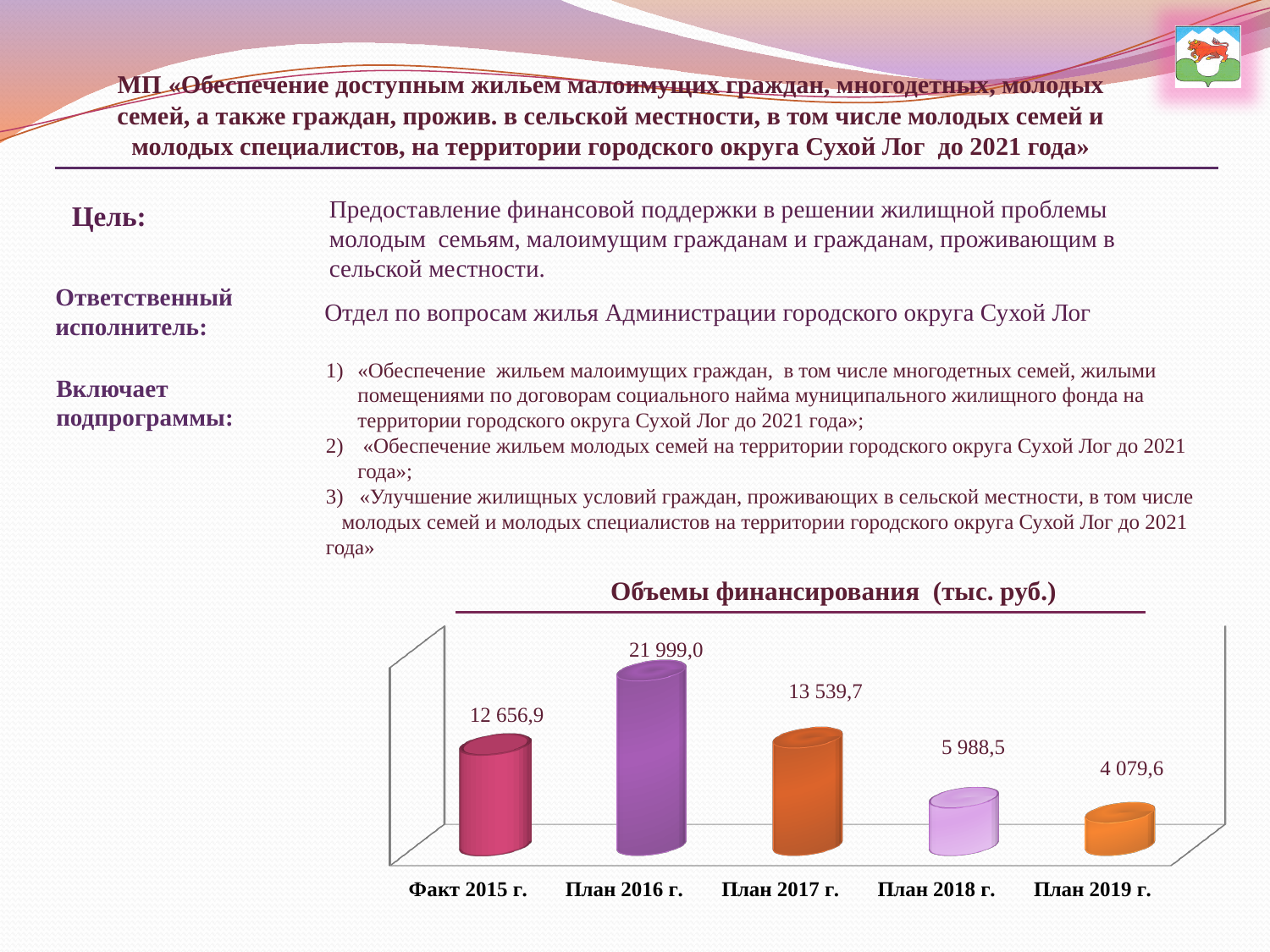
What is the value for План 2019 г.? 4 079,6 What kind of chart is shown on the slide? bar chart What is the value for План 2016 г.? 21 999,0 Which category has the lowest value? План 2019 г. Which category has the highest value? План 2016 г. What is the value for Факт 2015 г.? 12 656,9 Which is larger, the value for Факт 2015 г. or План 2017 г.? План 2017 г. What is the value for План 2018 г.? 5 988,5 What is the title of the chart? Объемы финансирования (тыс. руб.) What is the value for План 2017 г.? 13 539,7 How many categories are shown in the chart? 5 What is the difference between the values for План 2016 г. and План 2017 г.? 8 459,3